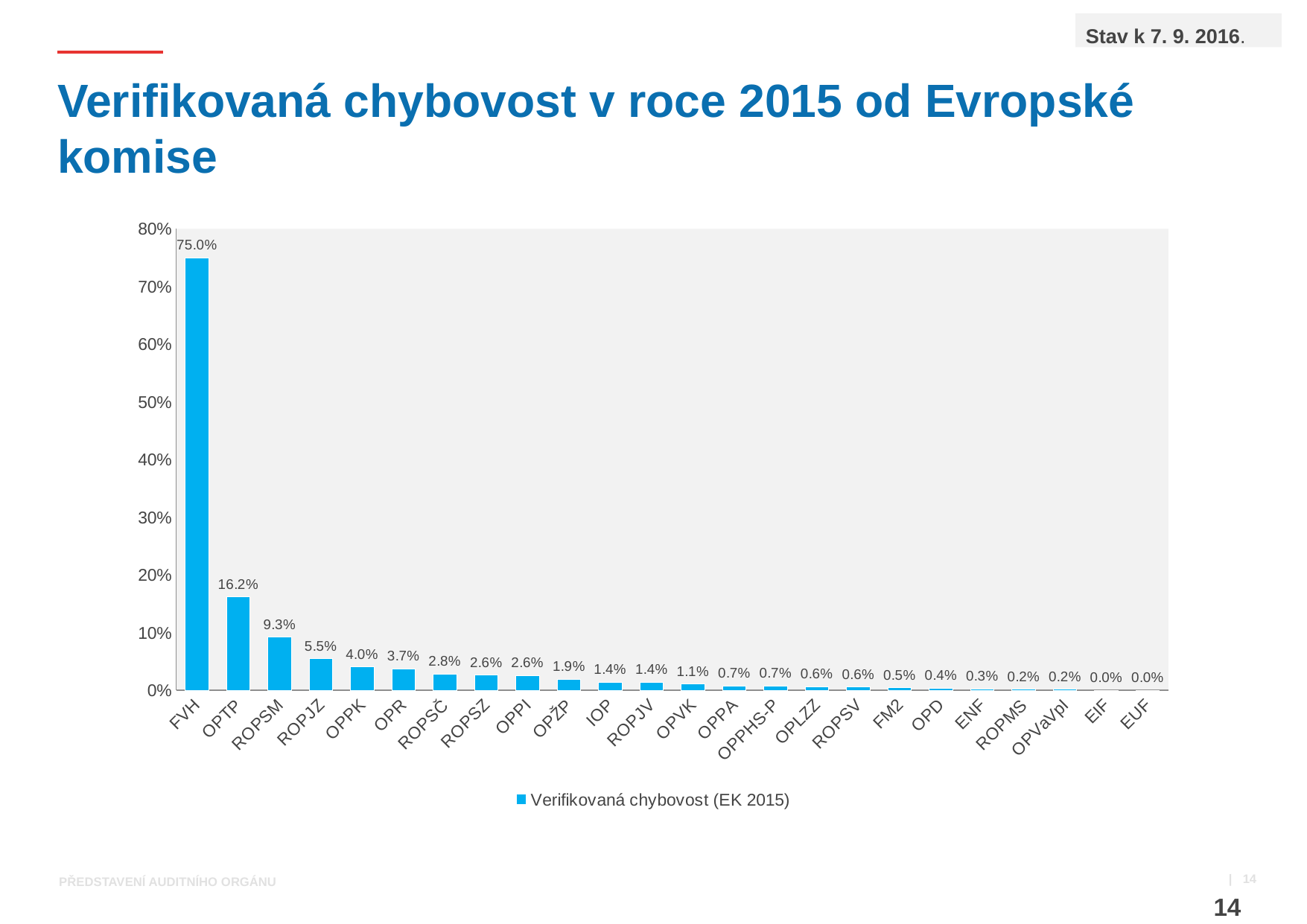
Which category has the highest value? FVH What is the difference between the values for FVH and OPTP? 58.8% What is the value shown for OPTP? 16.2% How many categories are shown on the x axis? 24 Which is larger, the value for OPR or the value for ROPSČ? OPR Is the value for FVH greater or less than 70%? greater What is the verified error rate for FVH? 75.0% What is the value shown for ROPSM? 9.3% What is the difference between the values for ROPJZ and OPPK? 1.5% What is the value shown for OPŽP? 1.9% What kind of chart is shown on the slide? bar chart How many series does the legend list? 1